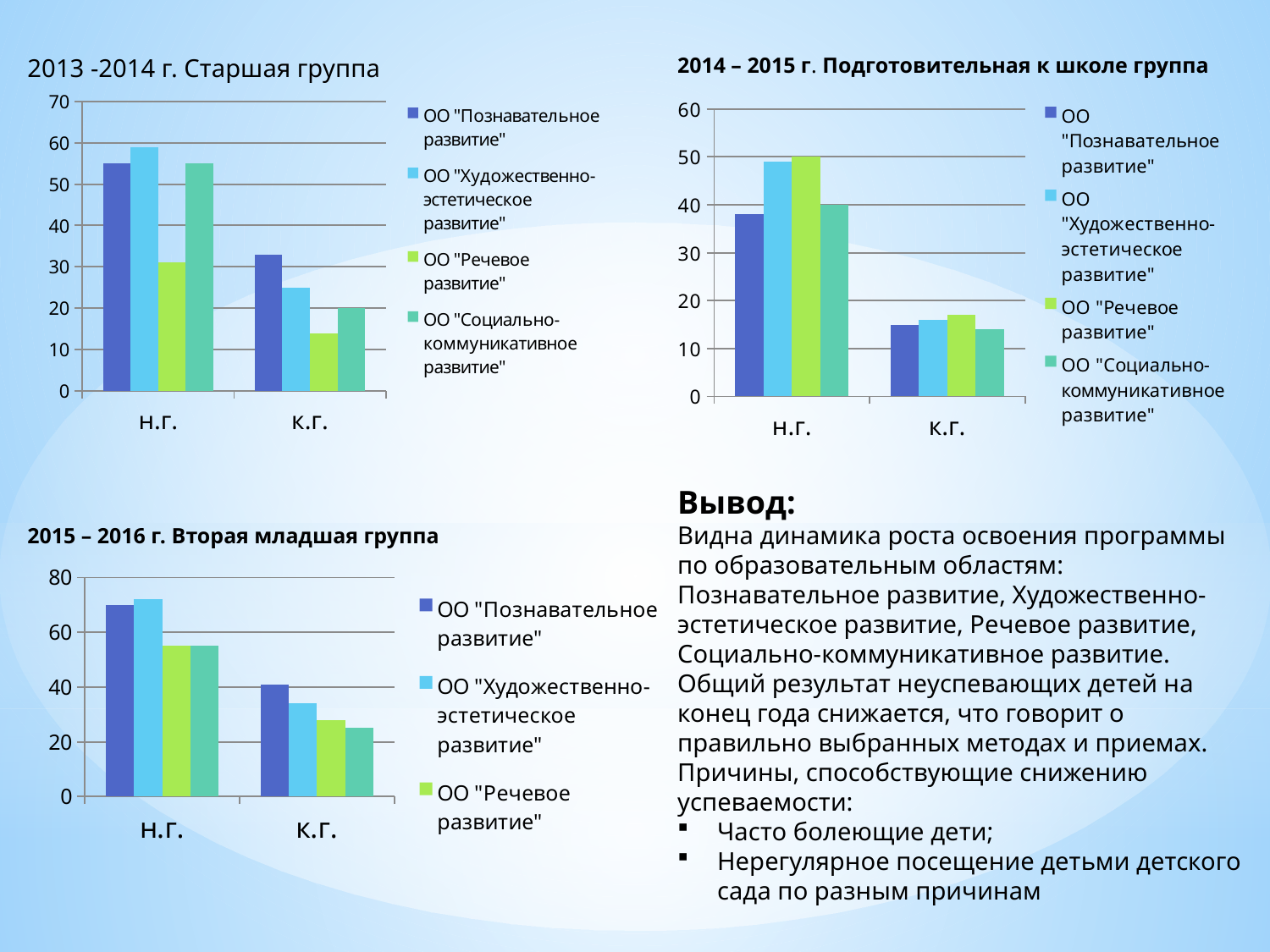
In the '2013 -2014 г. Старшая группа' chart, which series has the highest value for н.г.? ОО "Художественно-эстетическое развитие" In the '2014 – 2015 г. Подготовительная к школе группа' chart, do the values for ОО "Познавательное развитие" rise or fall from н.г. to к.г.? fall In the '2013 -2014 г. Старшая группа' chart, which series has the lowest value for к.г.? ОО "Речевое развитие" In the '2015 – 2016 г. Вторая младшая группа' chart, is the value of ОО "Художественно-эстетическое развитие" for н.г. greater or less than 60? greater How many categories are shown on the x axis of the '2014 – 2015 г. Подготовительная к школе группа' chart? 2 What kind of chart is the '2013 -2014 г. Старшая группа' chart? bar chart In the '2015 – 2016 г. Вторая младшая группа' chart, which series has the highest value for к.г.? ОО "Познавательное развитие" In the '2014 – 2015 г. Подготовительная к школе группа' chart, which is larger for к.г.: ОО "Речевое развитие" or ОО "Социально-коммуникативное развитие"? ОО "Речевое развитие" In the '2013 -2014 г. Старшая группа' chart, is the value of ОО "Речевое развитие" for н.г. greater or less than 40? less What is the title of the chart in the bottom-left of the slide? 2015 – 2016 г. Вторая младшая группа How many series does the legend of the '2013 -2014 г. Старшая группа' chart list? 4 In the '2014 – 2015 г. Подготовительная к школе группа' chart, is the value of ОО "Познавательное развитие" for н.г. greater or less than 30? greater